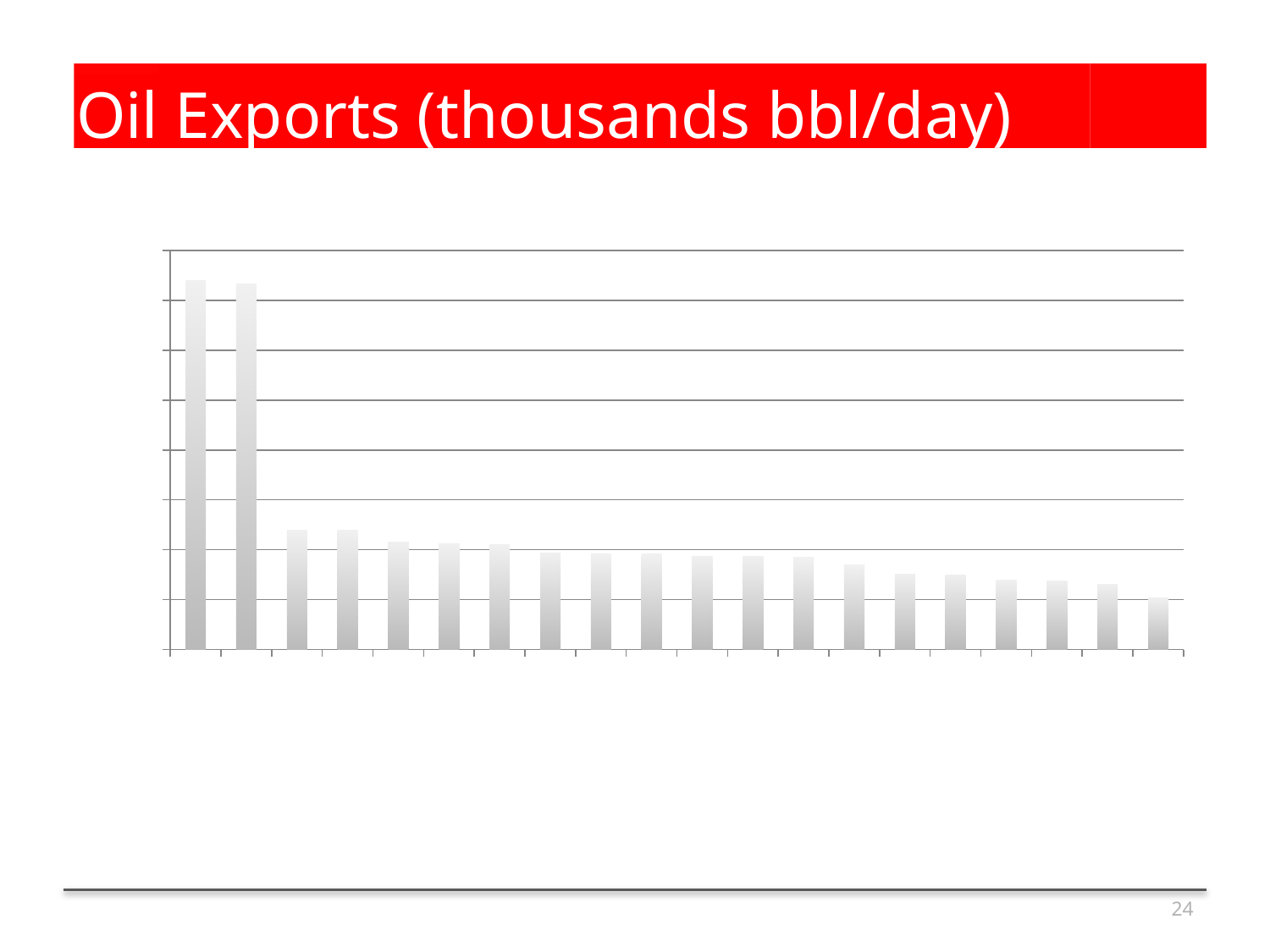
How many bars are plotted in the chart? 20 Which bar is the shortest in the chart, the leftmost or the rightmost? rightmost Which bar is the tallest in the chart, the leftmost or the rightmost? leftmost Do the bar values generally rise or fall from left to right along the x axis? fall Which is larger, the second bar from the left or the third bar from the left? second bar from the left What kind of chart is shown on the slide? bar chart Does the chart display a legend? No What is the title of the slide containing the chart? Oil Exports (thousands bbl/day)